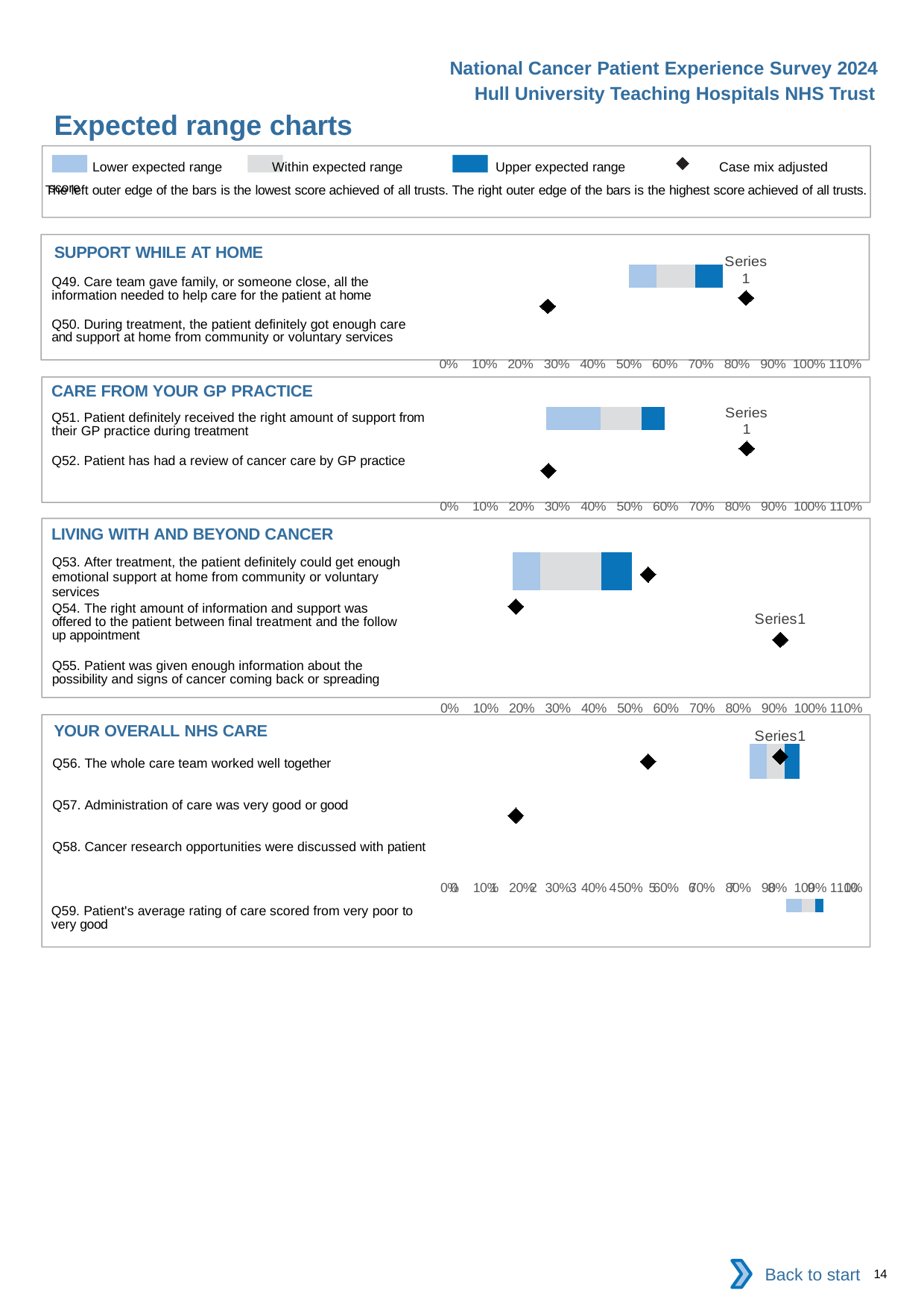
In the SUPPORT WHILE AT HOME chart, is the left edge of the expected range bar greater or less than 40%? greater Which colour in the legend represents the Upper expected range? dark blue How many questions are listed in the CARE FROM YOUR GP PRACTICE chart? 2 In the CARE FROM YOUR GP PRACTICE chart, is the right edge of the expected range bar greater or less than 70%? less How many questions are listed in the LIVING WITH AND BEYOND CANCER chart? 3 In the LIVING WITH AND BEYOND CANCER chart, is the leftmost case mix adjusted score marker greater or less than 30%? less What is the highest tick shown on the x axis of the SUPPORT WHILE AT HOME chart? 110% What kind of chart is used in the Expected range charts on this slide? bar chart How many entries does the legend at the top of the slide list? 4 How many questions are listed in the YOUR OVERALL NHS CARE chart? 4